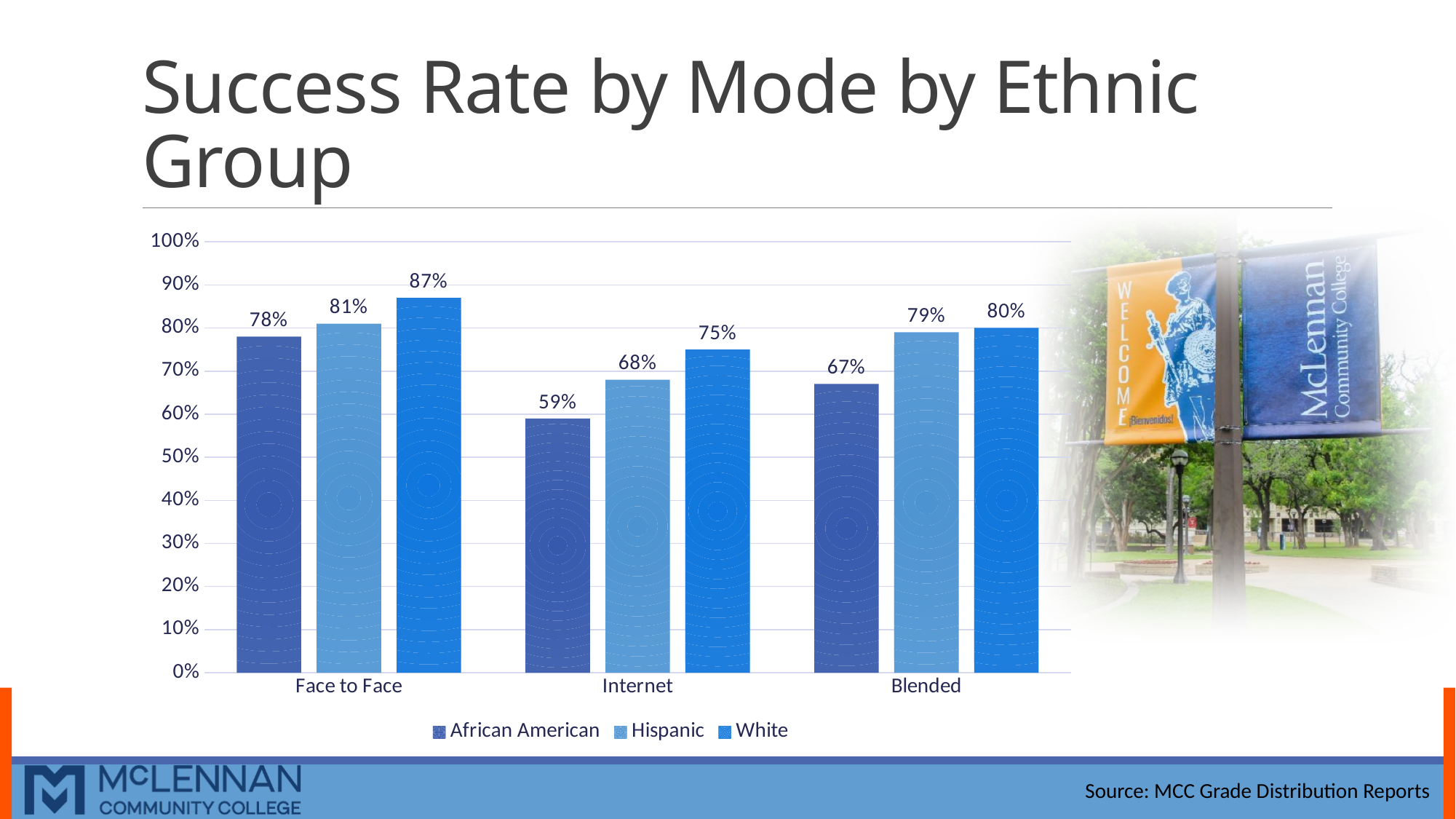
What is the difference between the Hispanic success rates in Face to Face and Internet modes? 13% How many series does the legend list? 3 How many modes are shown on the x axis? 3 What kind of chart is shown on the slide? Bar chart Is the success rate for African American students in the Internet mode greater or less than 60%? less Which mode has the highest success rate for White students? Face to Face What is the difference between the White and African American success rates in the Internet mode? 16% Which mode has the lowest success rate for African American students? Internet What is the success rate for White students in the Internet mode? 75% What is the success rate for African American students in the Face to Face mode? 78% Which is larger: the Hispanic success rate in Face to Face or the White success rate in Blended? Hispanic success rate in Face to Face What is the success rate for Hispanic students in the Blended mode? 79%